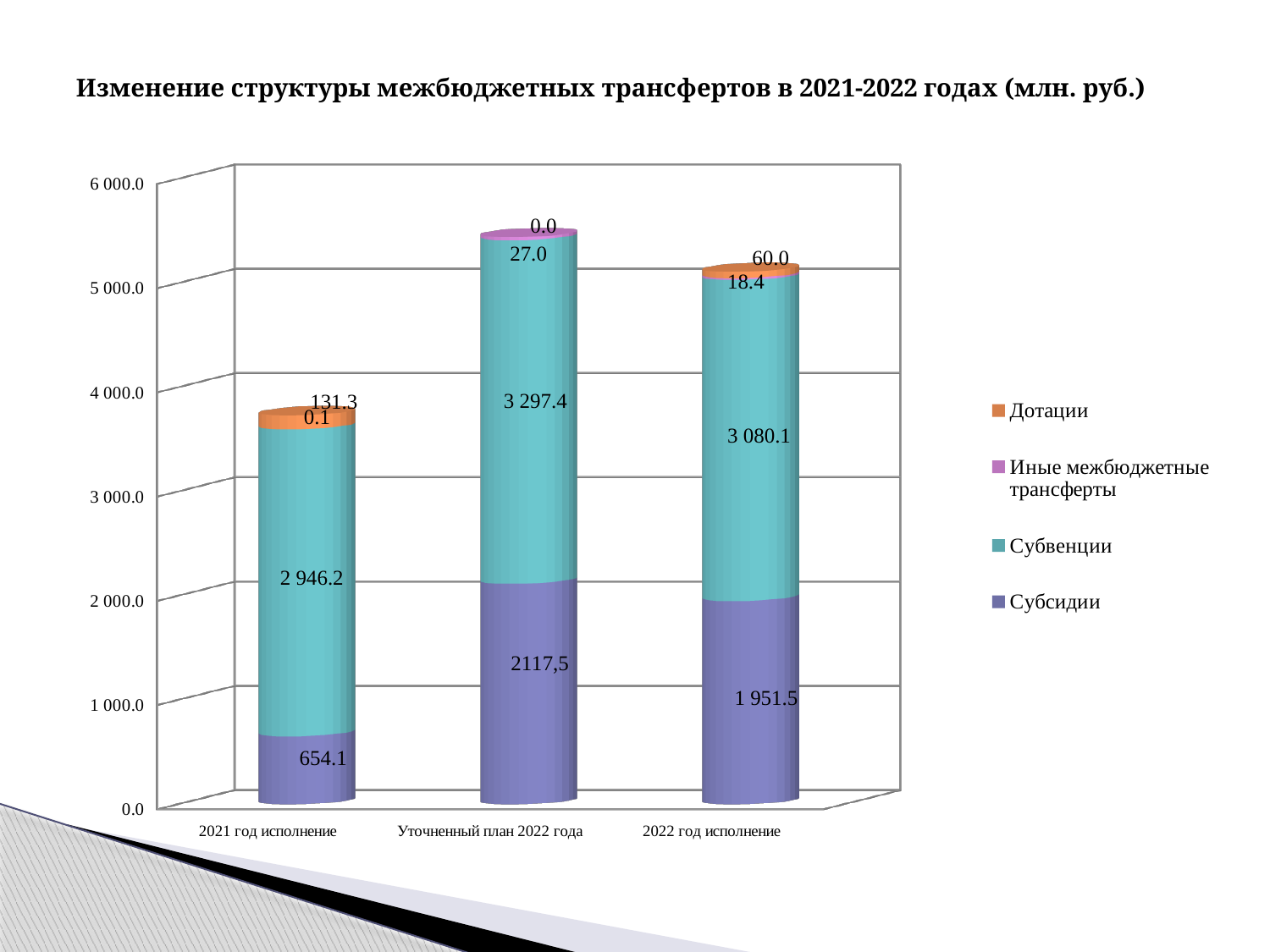
How many series does the legend list? 4 Which is larger: Дотации for 2021 год исполнение or Дотации for 2022 год исполнение? 2021 год исполнение What is the difference between the Субвенции values for Уточненный план 2022 года and 2022 год исполнение? 217.3 What is the value of Иные межбюджетные трансферты for 2022 год исполнение? 18.4 Which category has the highest value for Субвенции? Уточненный план 2022 года How many categories are shown on the x axis? 3 Which category has the lowest value for Субсидии? 2021 год исполнение What is the value of Субсидии for 2022 год исполнение? 1 951.5 What is the value of Дотации for Уточненный план 2022 года? 0.0 What is the total of the stacked bar for 2021 год исполнение? 3 731.7 What kind of chart is shown on the slide? Stacked bar chart What is the value of Субвенции for 2021 год исполнение? 2 946.2